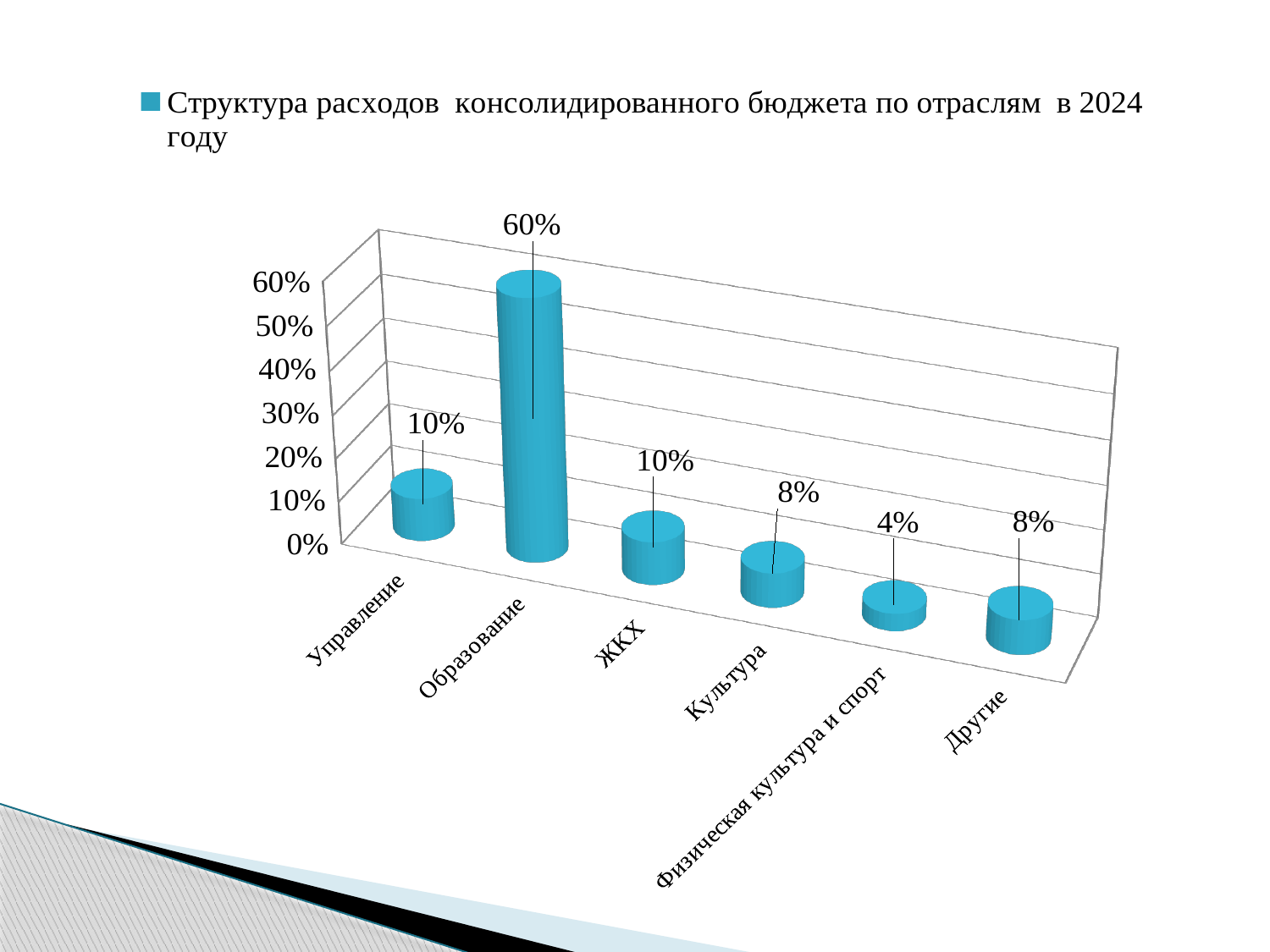
How many series does the legend list? 1 Which is larger, the value for ЖКХ or the value for Физическая культура и спорт? ЖКХ How many categories are shown on the x axis? 6 What is the legend entry shown above the chart? Структура расходов консолидированного бюджета по отраслям в 2024 году What kind of chart is shown on the slide? bar chart What is the value for Культура? 8% What is the value for Физическая культура и спорт? 4% What is the difference between the values for Образование and Управление? 50% What is the value for Образование? 60% Which category has the highest value? Образование Which category has the lowest value? Физическая культура и спорт Is the value for Образование greater or less than 50%? greater